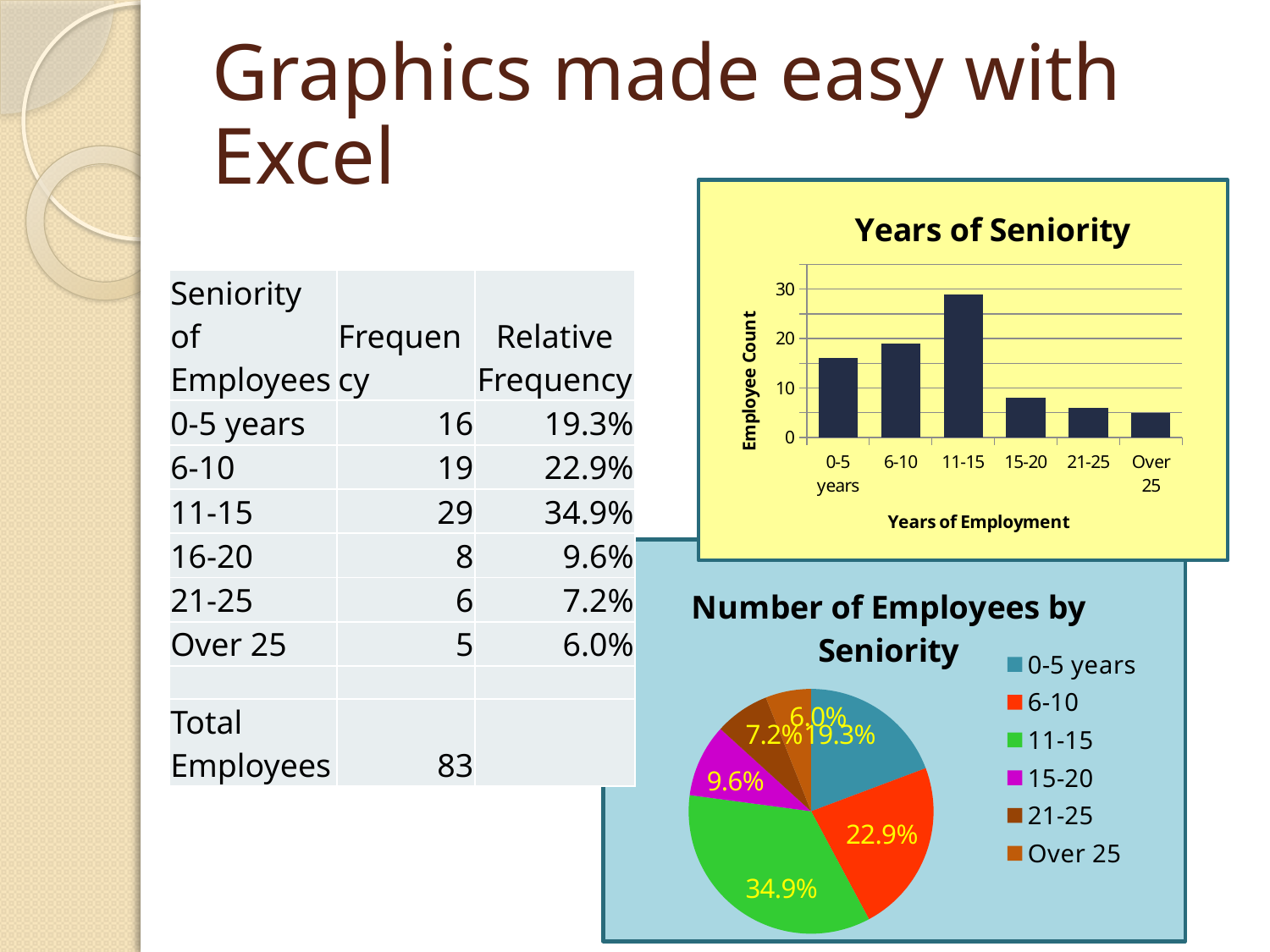
In the 'Years of Seniority' bar chart, which category has the lowest employee count? Over 25 What kind of chart is the 'Years of Seniority' chart? bar chart What is the y-axis title of the 'Years of Seniority' bar chart? Employee Count In the 'Number of Employees by Seniority' pie chart, what share is labelled for the 11-15 slice? 34.9% In the 'Number of Employees by Seniority' pie chart, what percentage is shown for 6-10? 22.9% In the 'Number of Employees by Seniority' pie chart, what is the difference between the 6-10 share and the 0-5 years share? 3.6% In the 'Years of Seniority' bar chart, how many categories are shown on the x axis? 6 In the 'Years of Seniority' bar chart, is the value for 0-5 years greater or less than 10? greater In the 'Years of Seniority' bar chart, is the value for 11-15 greater or less than 20? greater In the 'Years of Seniority' bar chart, which category has the highest employee count? 11-15 How many entries does the legend of the 'Number of Employees by Seniority' pie chart list? 6 In the 'Years of Seniority' bar chart, which is larger, the bar for 6-10 or the bar for 15-20? 6-10